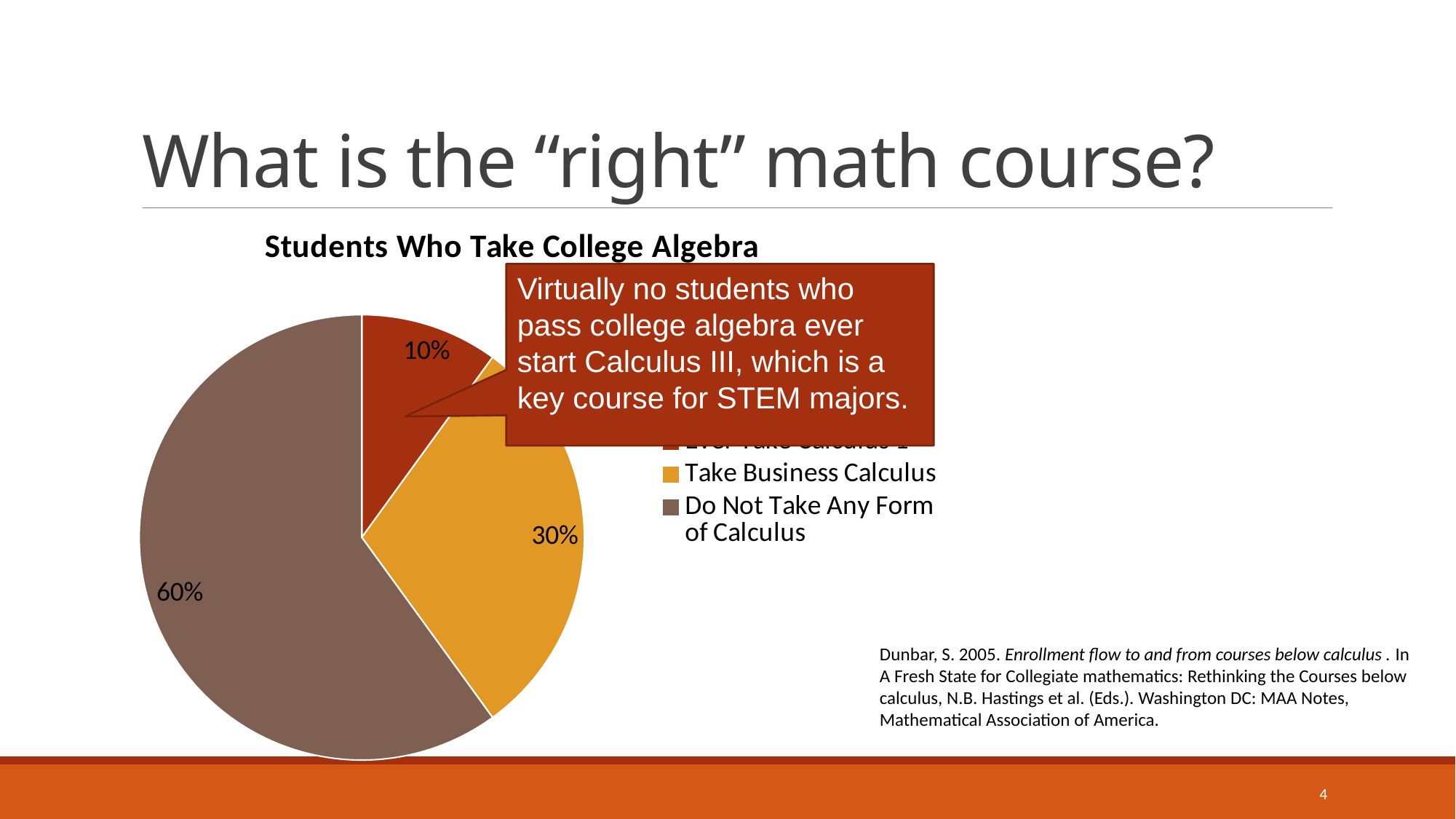
How many entries does the legend list? 3 What is the difference between the Take Business Calculus slice and the smallest slice? 20% What is the smallest percentage shown on the pie chart? 10% What is the difference between the Do Not Take Any Form of Calculus slice and the Take Business Calculus slice? 30% Which category has the largest slice of the pie? Do Not Take Any Form of Calculus What kind of chart is shown on the slide? pie chart What colour is the Do Not Take Any Form of Calculus slice? brown How many slices does the pie chart have? 3 What percentage of students Take Business Calculus? 30% What is the title of the chart? Students Who Take College Algebra What percentage of students Do Not Take Any Form of Calculus? 60% Which is larger: Take Business Calculus or Do Not Take Any Form of Calculus? Do Not Take Any Form of Calculus